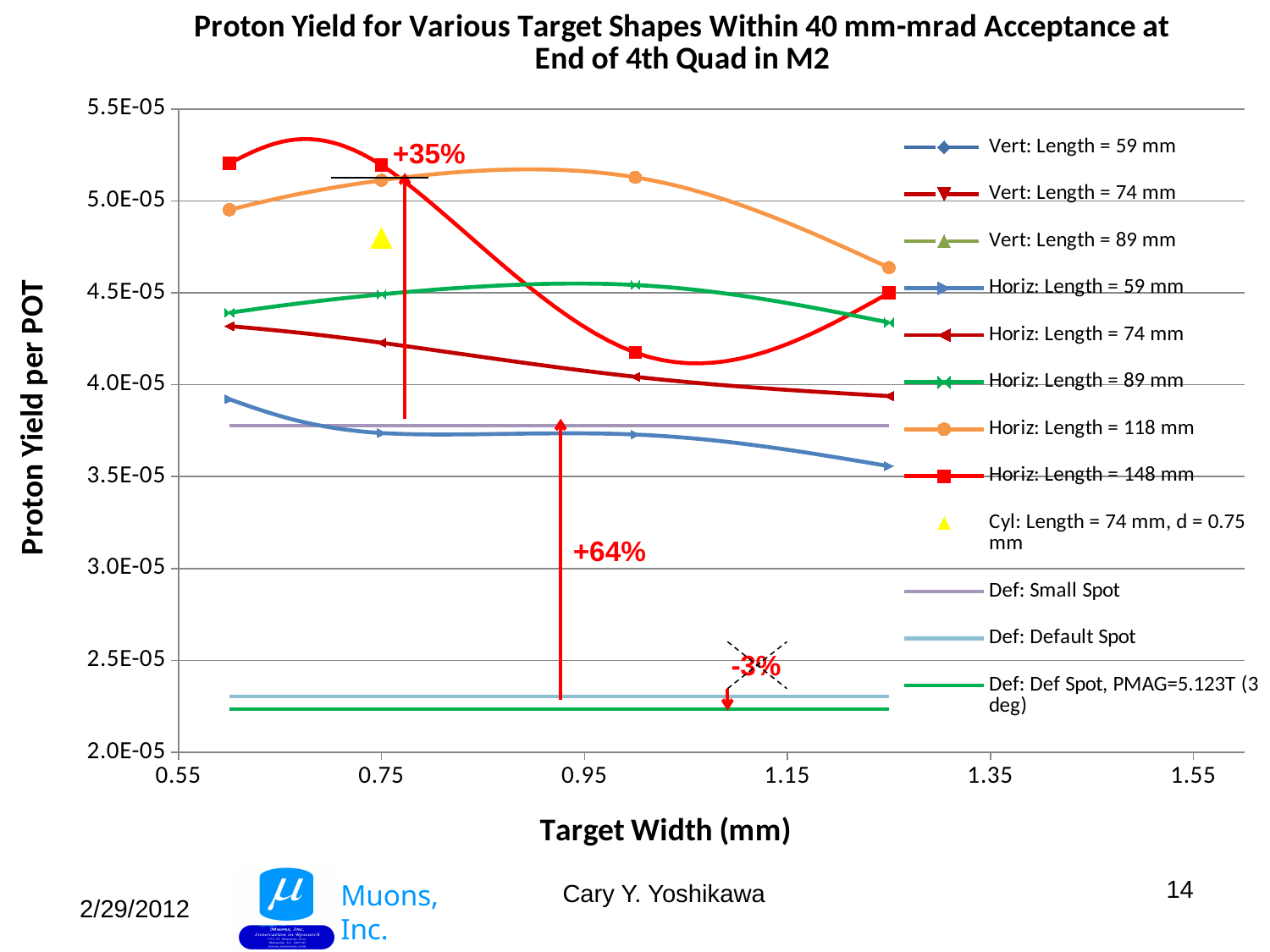
How many data points are plotted for the Horiz: Length = 118 mm series? 4 How many series does the legend list? 12 Is the value for Horiz: Length = 118 mm at a target width of 1.0 mm greater or less than 5.0E-05? greater At a target width of 1.25 mm, which is larger: Horiz: Length = 118 mm or Horiz: Length = 59 mm? Horiz: Length = 118 mm What kind of chart is shown on the slide? line chart Is the value for Horiz: Length = 59 mm at a target width of 1.25 mm greater or less than 4.0E-05? less Is the Def: Default Spot line greater or less than 2.5E-05? less Does the Horiz: Length = 74 mm series rise or fall as target width increases? fall Which series lies lowest on the chart? Def: Def Spot, PMAG=5.123T (3 deg) What is the title of the x axis? Target Width (mm) Which series has the highest value at a target width of 0.6 mm? Horiz: Length = 148 mm